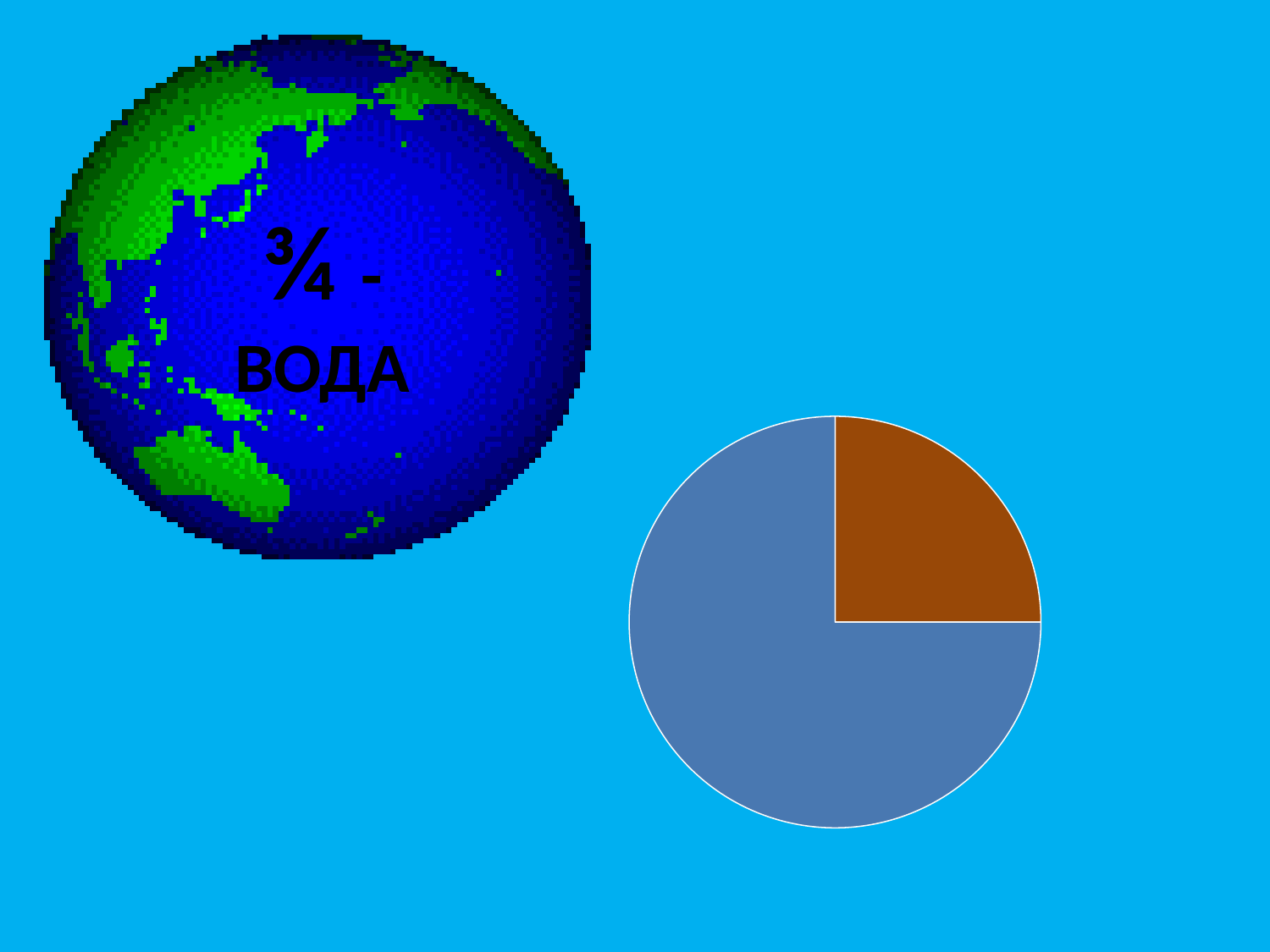
Does the pie chart have a legend? No Which slice of the pie chart is the smallest? the brown slice What colour is the larger slice of the pie chart? blue How many slices does the pie chart have? 2 Does the brown slice take up more or less than half of the pie chart? less Does the blue slice take up more or less than half of the pie chart? more Which slice of the pie chart is larger, the blue one or the brown one? the blue one What kind of chart is shown on the slide? pie chart